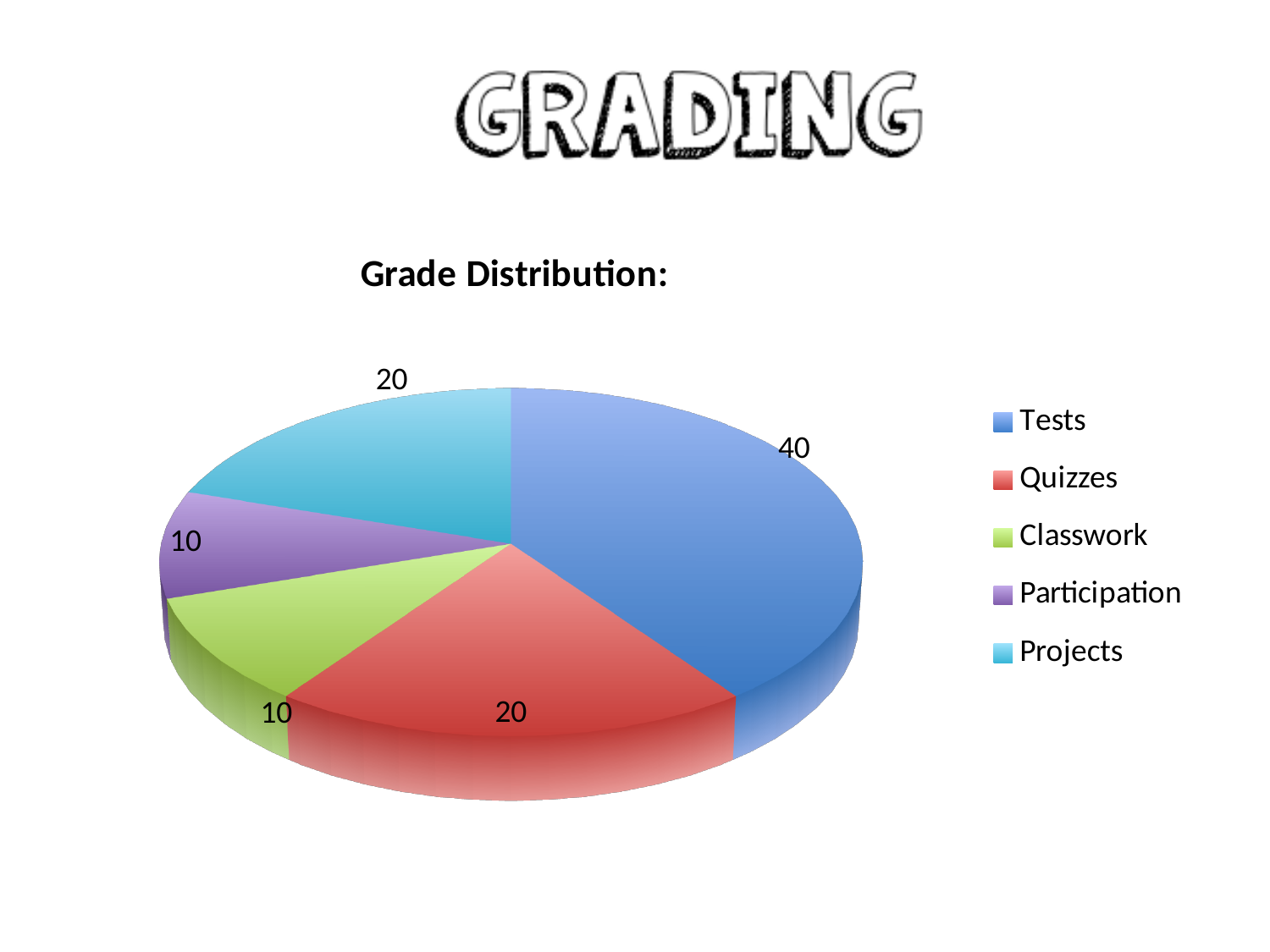
What is the title of the chart on the slide? Grade Distribution: Which is larger, the value for Classwork or the value for Projects? Projects What is the value for Tests in the Grade Distribution pie chart? 40 Which colour represents Classwork in the legend? Green What is the value for Quizzes in the Grade Distribution pie chart? 20 What is the value for Projects in the Grade Distribution pie chart? 20 What kind of chart is shown on the slide? Pie chart What share of the pie does the Tests slice represent? 40% How many categories are shown in the Grade Distribution pie chart? 5 Which category has the largest slice in the Grade Distribution pie chart? Tests What is the difference between the values for Tests and Quizzes? 20 What is the value for Participation in the Grade Distribution pie chart? 10